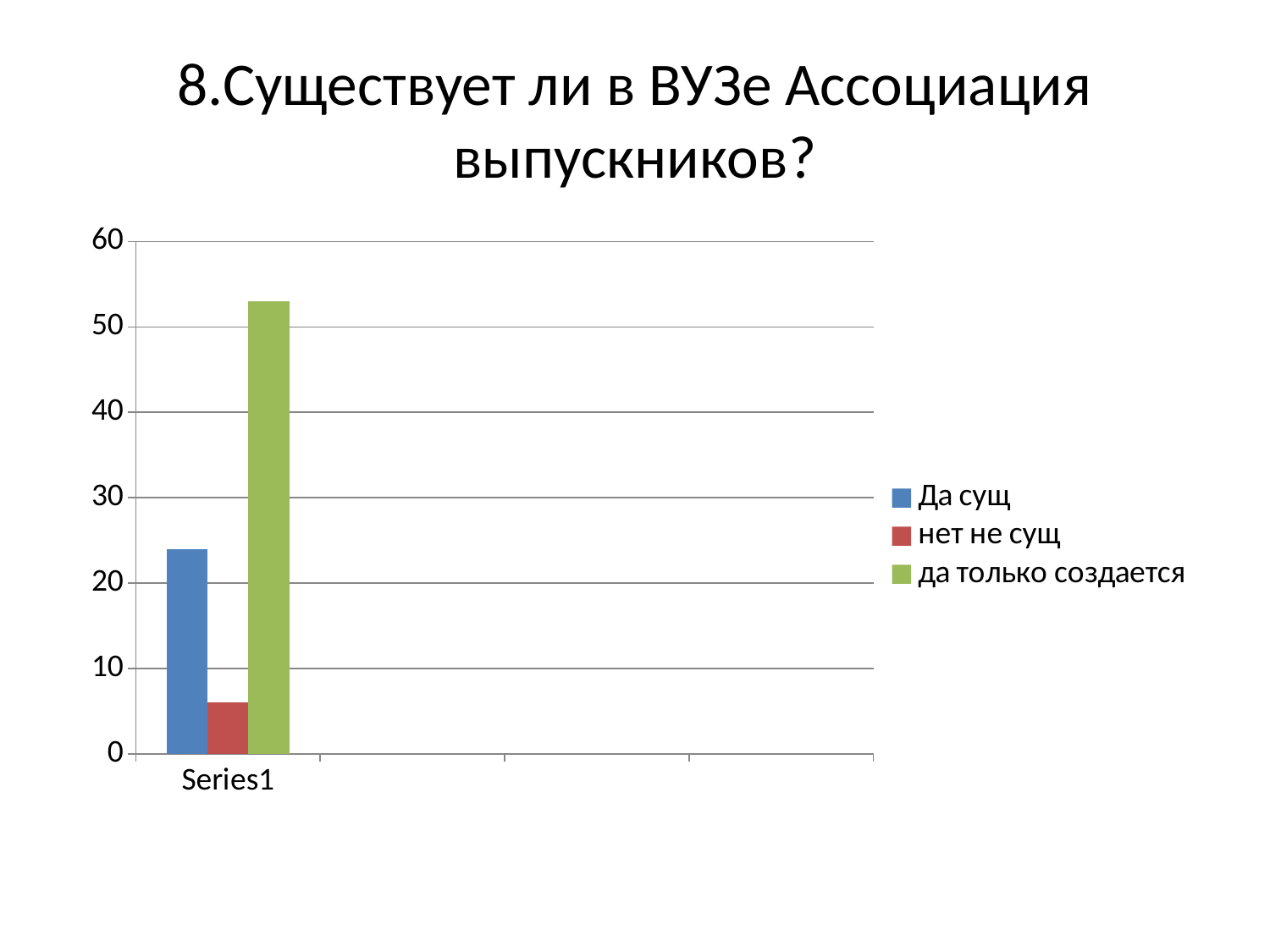
What colour is the bar for "да только создается"? green Is the value for "Да сущ" greater or less than 20? greater Is the value for "да только создается" greater or less than 50? greater Which series has the highest value? да только создается Which is larger, the value for "да только создается" or the value for "Да сущ"? да только создается Which series has the lowest value? нет не сущ Is the value for "нет не сущ" greater or less than 10? less What kind of chart is shown on the slide? bar chart How many series does the legend list? 3 What is the title of the chart? 8.Существует ли в ВУЗе Ассоциация выпускников? Which is larger, the value for "Да сущ" or the value for "нет не сущ"? Да сущ